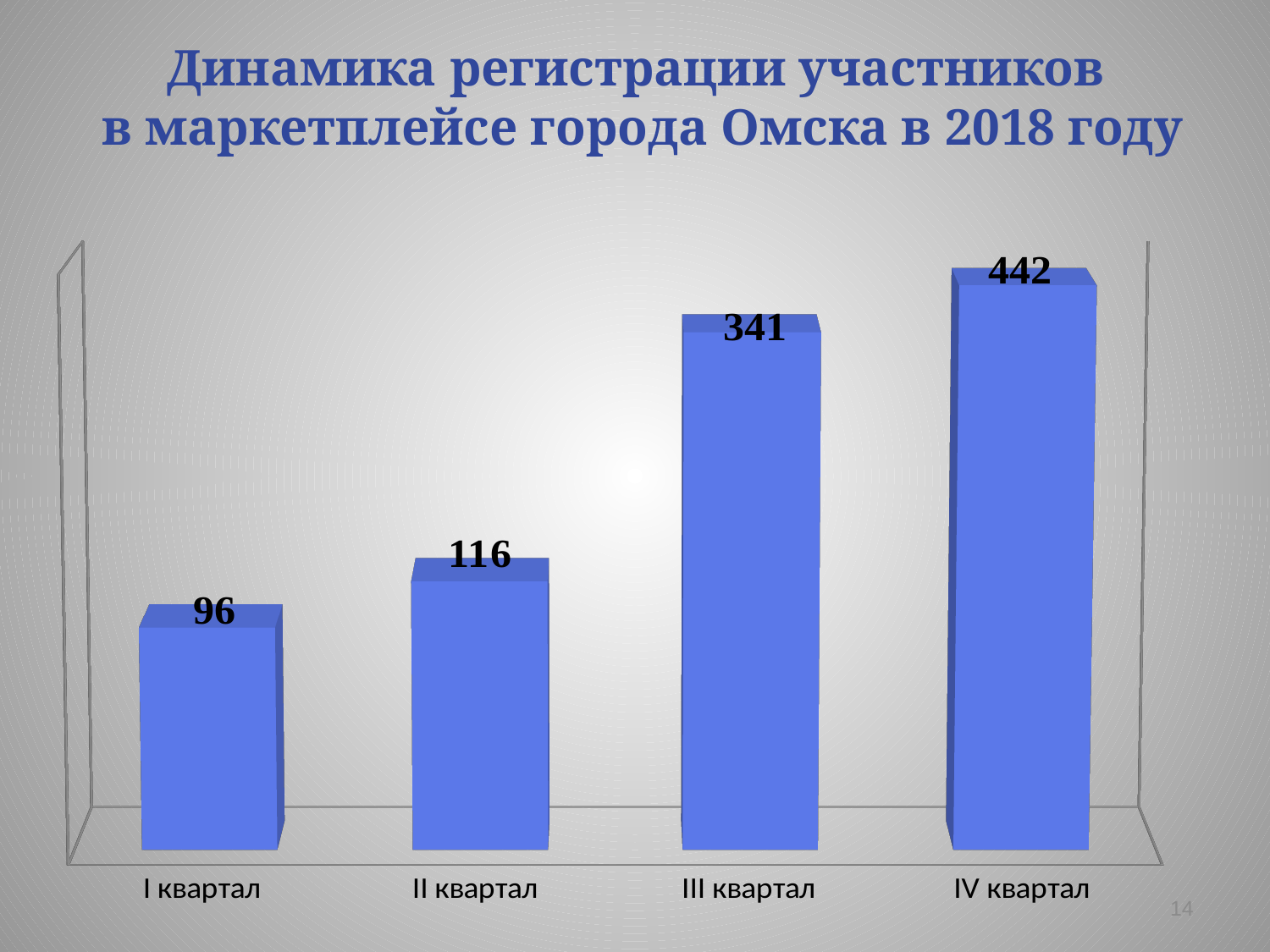
Which quarter has the lowest value? I квартал What is the value for I квартал? 96 How many categories are shown on the chart? 4 What is the value for II квартал? 116 What is the value for III квартал? 341 What is the value for IV квартал? 442 What is the difference between the values for II квартал and I квартал? 20 Which is larger, the value for III квартал or the value for II квартал? III квартал What is the difference between the values for IV квартал and III квартал? 101 Do the values rise or fall from I квартал to IV квартал? Rise What kind of chart is shown on the slide? Bar chart Which quarter has the highest value? IV квартал